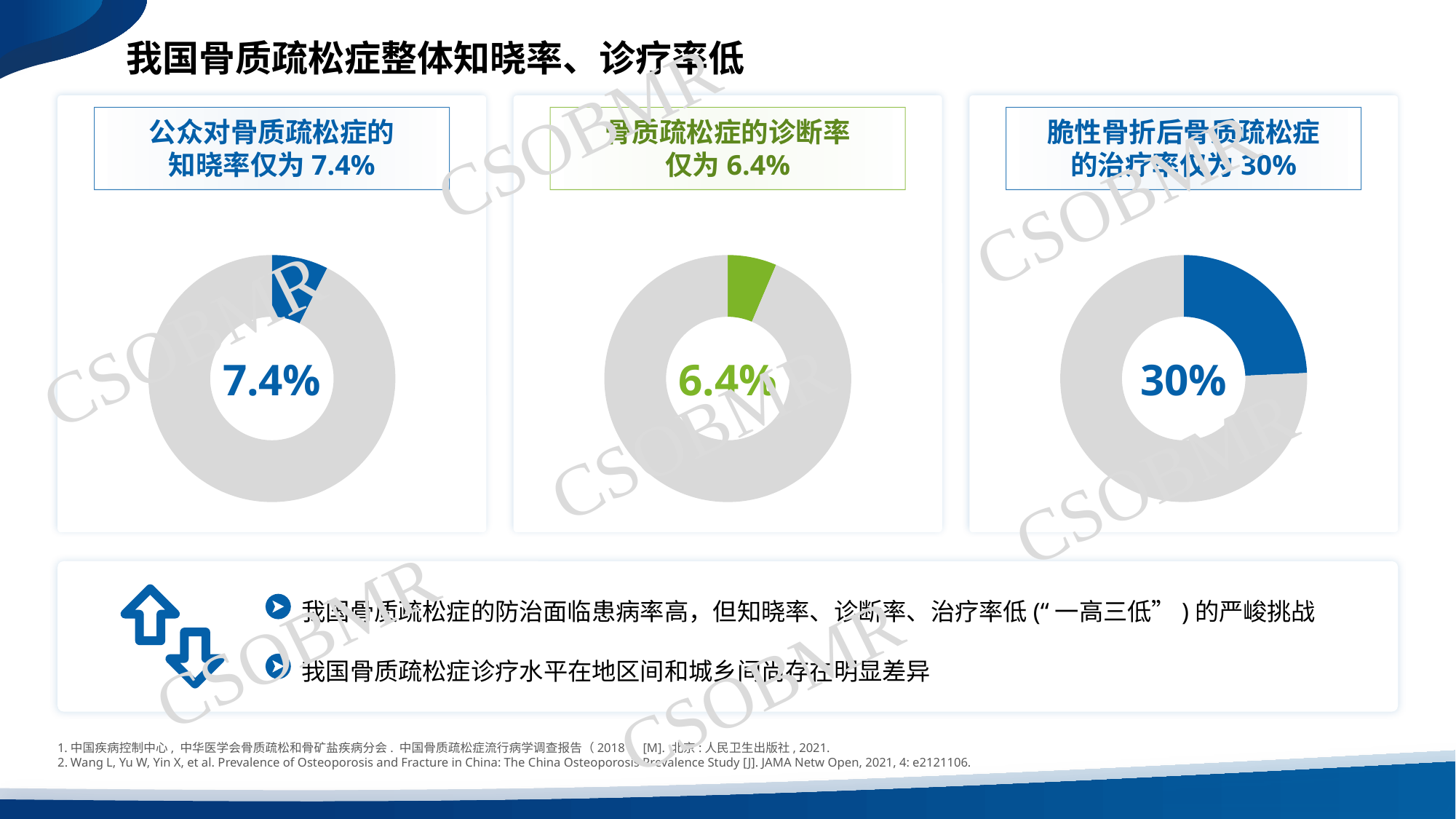
Which of the three donut charts shows the highest percentage? The right chart (治疗率, 30%) What kind of chart is used in each of the three panels on the slide? Donut (pie) chart What colour is the highlighted slice in the right donut chart (治疗率)? Blue What value is shown in the centre of the middle donut chart (骨质疏松症的诊断率)? 6.4% What value is shown in the centre of the left donut chart (公众对骨质疏松症的知晓率)? 7.4% What colour is the highlighted slice in the middle donut chart (诊断率)? Green What is the difference between the 治疗率 in the right chart and the 知晓率 in the left chart? 22.6% What value is shown in the centre of the right donut chart (脆性骨折后骨质疏松症的治疗率)? 30% How many donut charts are shown on the slide? 3 Which of the three donut charts shows the lowest percentage? The middle chart (诊断率, 6.4%) Which is larger: the 知晓率 in the left chart or the 诊断率 in the middle chart? 知晓率 (7.4%) What is the difference between the 知晓率 in the left chart and the 诊断率 in the middle chart? 1.0%